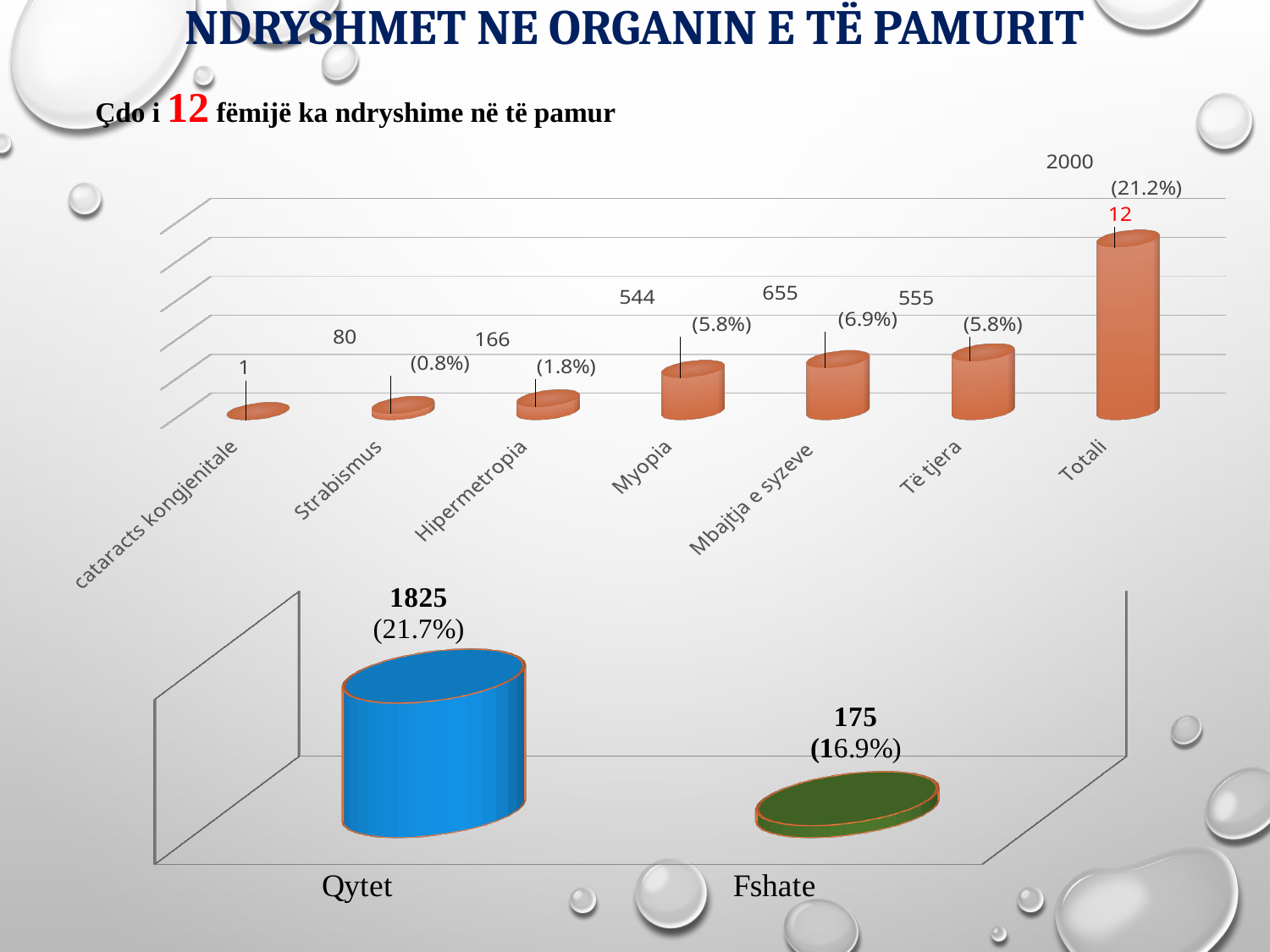
In the top chart, what is the value for Strabismus? 80 In the bottom chart, what is the difference between the values for Qytet and Fshate? 1650 In the top chart, which is larger, the value for Hipermetropia or the value for Strabismus? Hipermetropia How many categories are shown in the top chart? 7 In the top chart, which category has the lowest value? cataracts kongjenitale In the top chart, what is the value for Myopia? 544 In the bottom chart, what is the value for Qytet? 1825 In the top chart, what is the value for Totali? 2000 What kind of chart is the bottom chart? Bar chart In the top chart, what is the value for Mbajtja e syzeve? 655 In the top chart, what is the difference between the values for Mbajtja e syzeve and Të tjera? 100